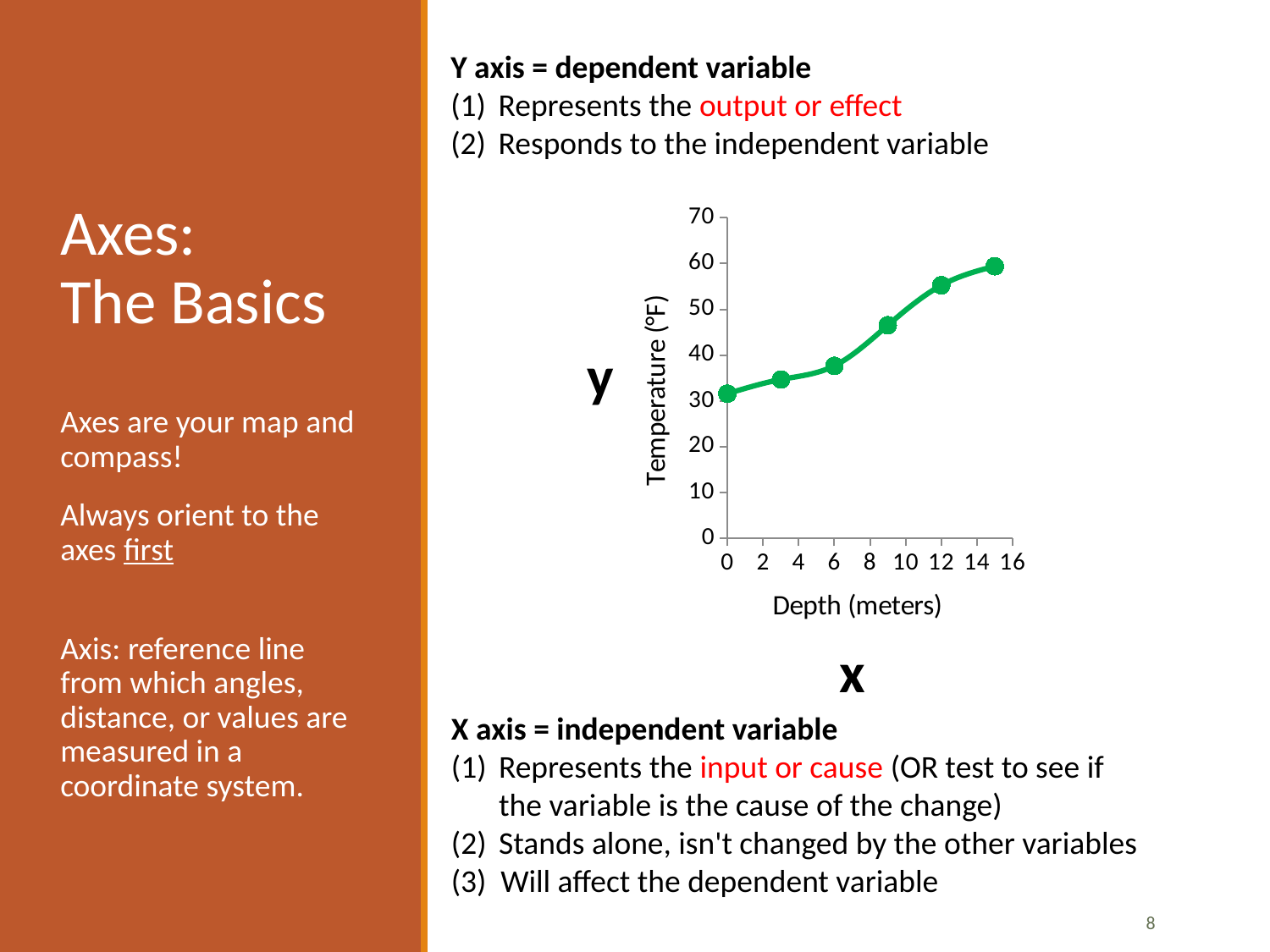
What is the label of the y axis of the chart? Temperature (°F) Is the temperature at a depth of 6 meters greater or less than 40? less Does temperature rise or fall as depth increases along the x axis? rise Is the temperature at a depth of 12 meters greater or less than 60? less Which has the higher temperature, a depth of 3 meters or a depth of 12 meters? 12 meters Is the temperature at a depth of 0 meters greater or less than 40? less At which depth is the temperature lowest? 0 meters At which depth is the temperature highest? 15 meters What kind of chart is shown on the slide? line chart How many data points are plotted on the line? 6